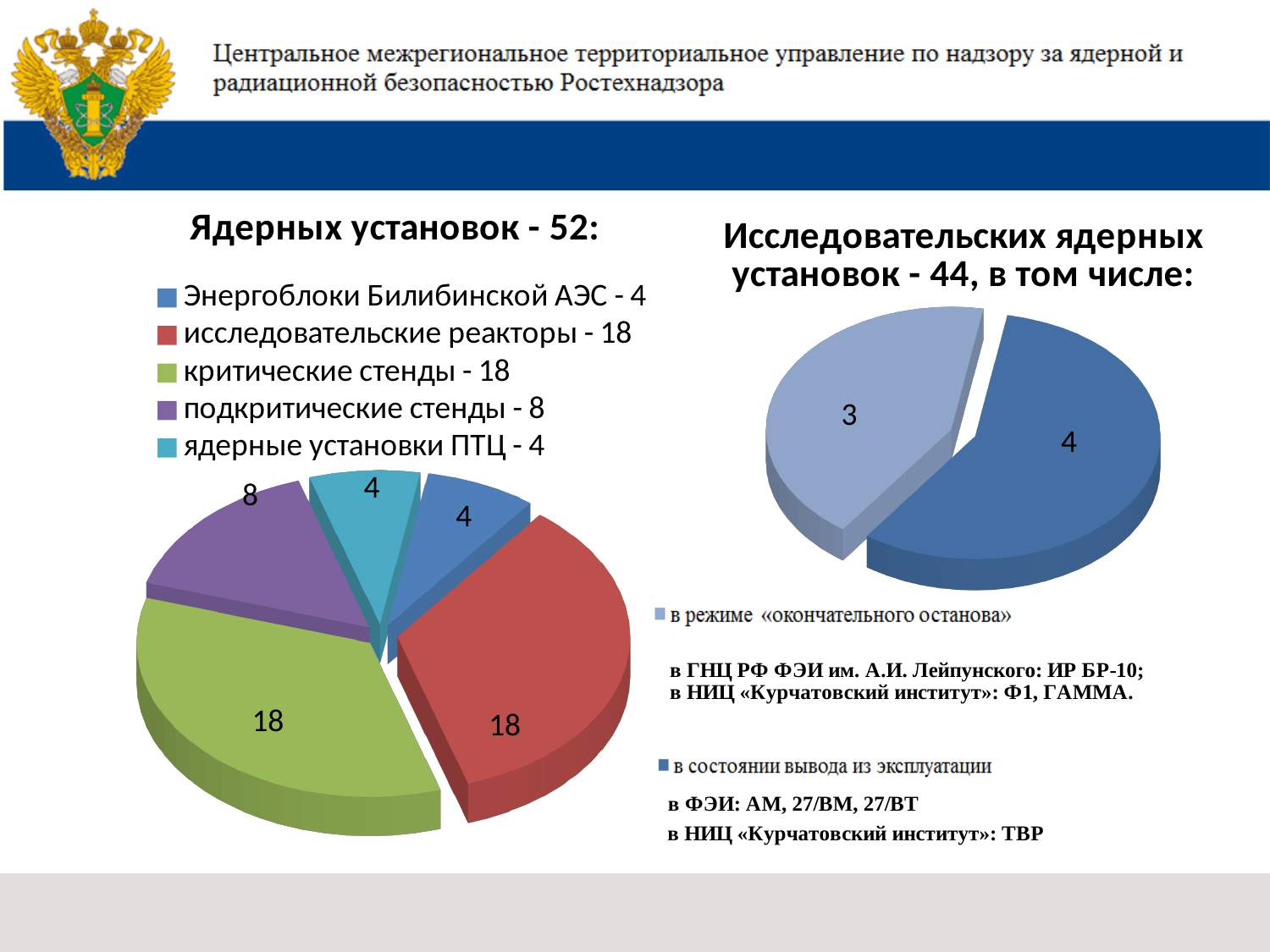
On the right chart titled 'Исследовательских ядерных установок - 44, в том числе:', what is the value for 'в состоянии вывода из эксплуатации'? 4 On the left chart titled 'Ядерных установок - 52:', what is the value for 'подкритические стенды'? 8 On the left chart titled 'Ядерных установок - 52:', which is larger: 'подкритические стенды' or 'ядерные установки ПТЦ'? подкритические стенды On the right chart titled 'Исследовательских ядерных установок - 44, в том числе:', which slice is the largest? в состоянии вывода из эксплуатации On the left chart titled 'Ядерных установок - 52:', what colour is the slice for 'критические стенды'? green What kind of chart is the left chart titled 'Ядерных установок - 52:'? pie chart On the right chart titled 'Исследовательских ядерных установок - 44, в том числе:', what is the value for 'в режиме «окончательного останова»'? 3 On the left chart titled 'Ядерных установок - 52:', what is the value for 'Энергоблоки Билибинской АЭС'? 4 On the right chart titled 'Исследовательских ядерных установок - 44, в том числе:', how many slices does the pie have? 2 On the left chart titled 'Ядерных установок - 52:', what is the value for 'исследовательские реакторы'? 18 On the left chart titled 'Ядерных установок - 52:', what is the difference between 'критические стенды' and 'подкритические стенды'? 10 On the left chart titled 'Ядерных установок - 52:', how many categories does the legend list? 5